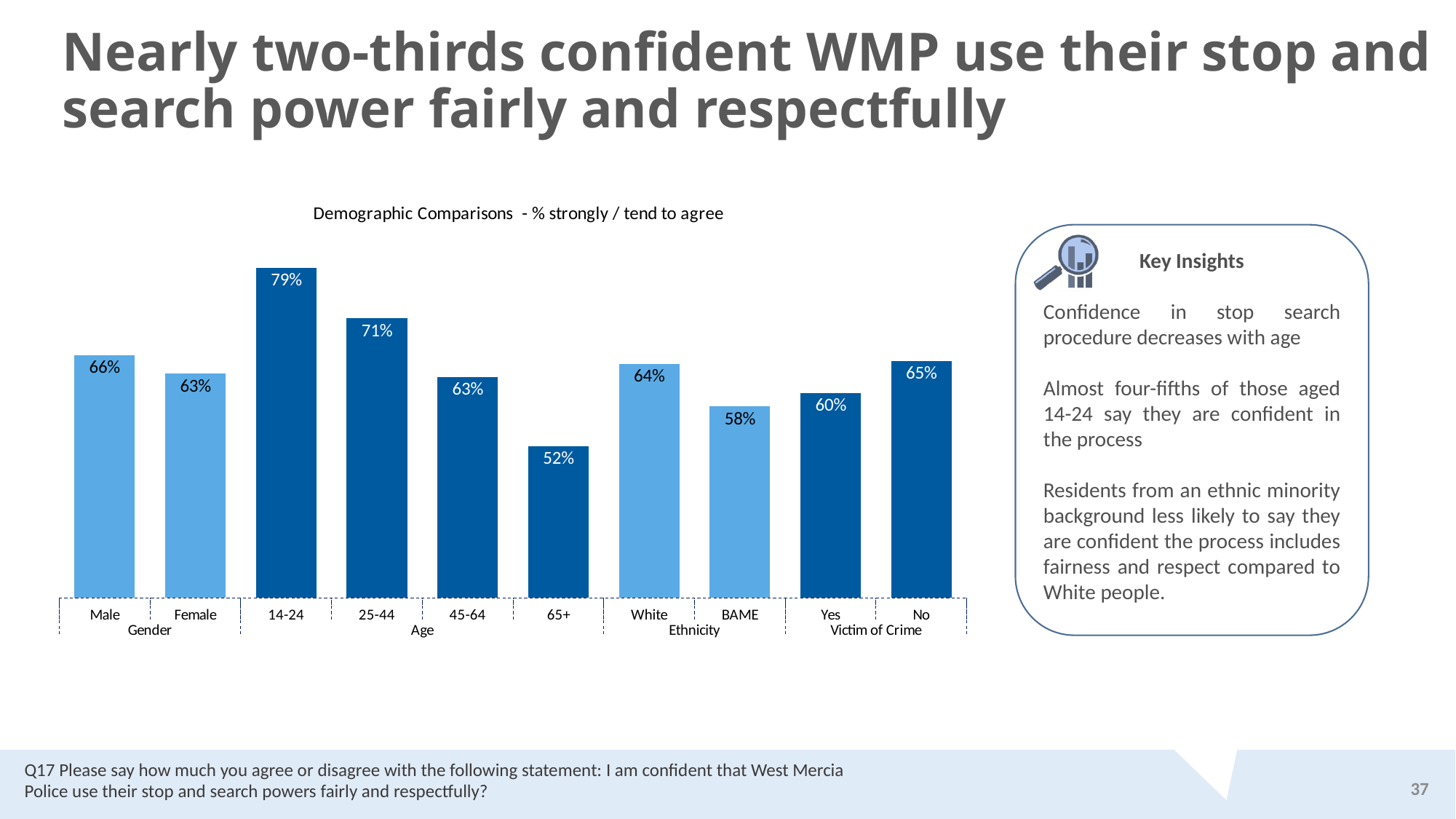
Which category has the highest value? 14-24 Which category has the lowest value? 65+ Do the values rise or fall across the age groups from 14-24 to 65+? Fall What is the difference between the values for White and BAME respondents? 6 percentage points Which is larger, the value for Yes or No under Victim of Crime? No What kind of chart is shown? Bar chart What is the difference between the values for the 14-24 and 65+ age groups? 27 percentage points What is the value for the 14-24 age group? 79% How many bars are shown in the chart? 10 What is the value for Male respondents? 66% What is the title of the chart? Demographic Comparisons - % strongly / tend to agree What is the value for BAME respondents? 58%